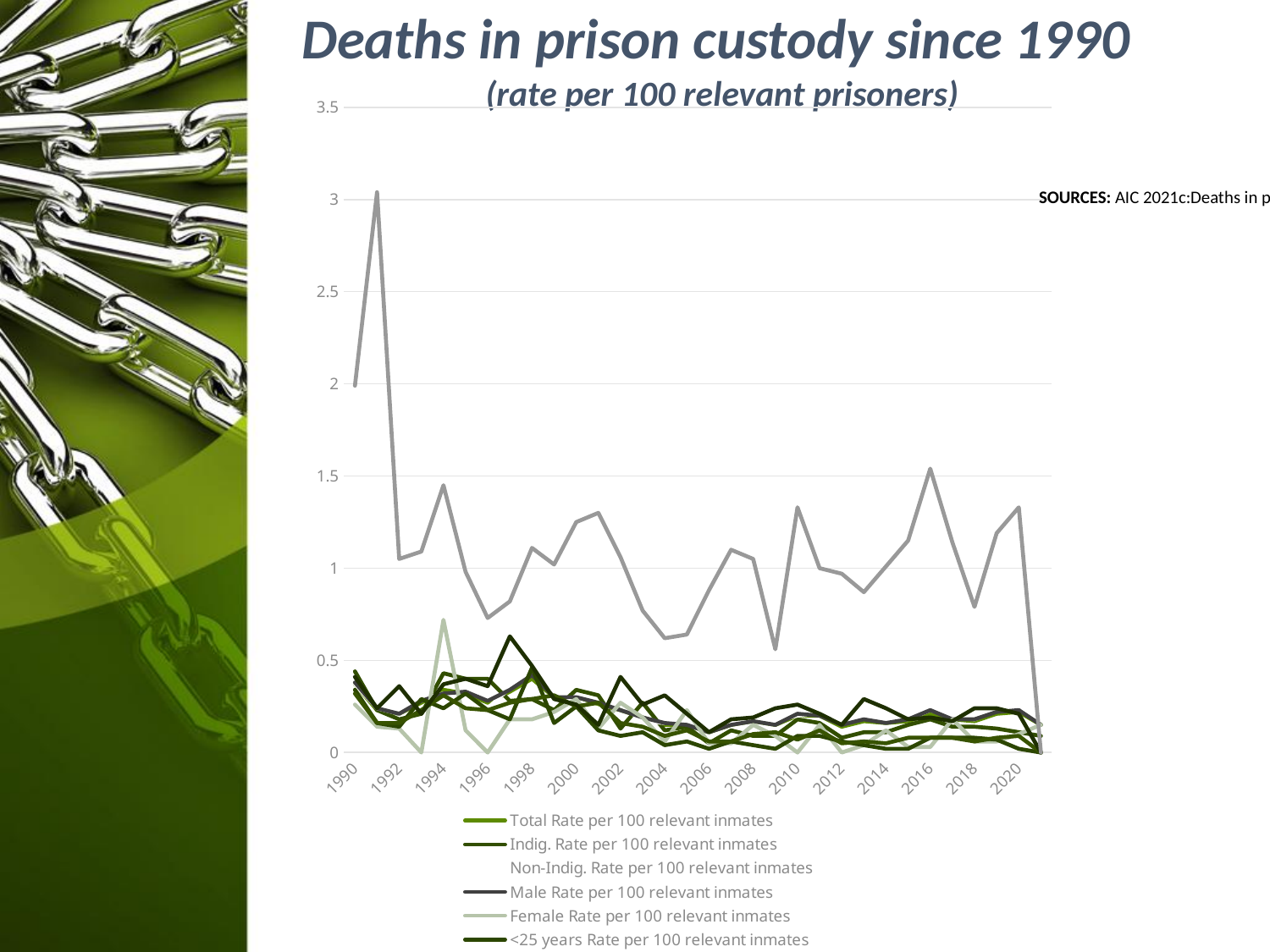
Does the grey line rise or fall between 1990 and 1991? rise Is the Female Rate per 100 relevant inmates in 1993 greater or less than 0.5? less Is the Female Rate per 100 relevant inmates in 1994 greater or less than 0.5? greater What is the title of the chart? Deaths in prison custody since 1990 (rate per 100 relevant prisoners) In which year does the grey line reach its highest value? 1991 What is the highest value shown on the vertical axis? 3.5 How many series does the legend list? 6 Is the value of the grey line in 2016 greater or less than 1? greater What kind of chart is shown on the slide? line chart Does the grey line rise or fall between 1991 and 1992? fall